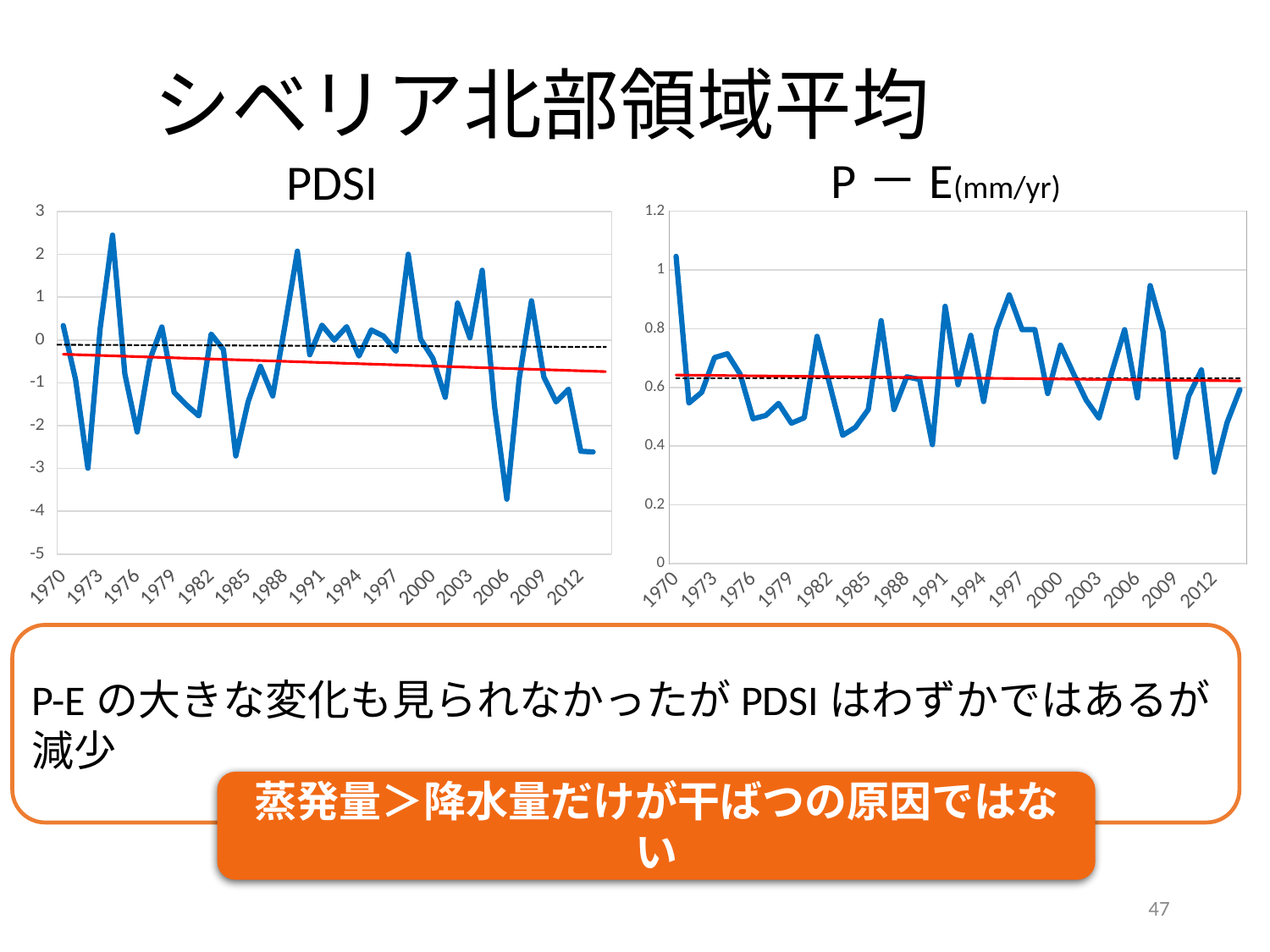
In the PDSI chart, does the red trend line rise or fall from 1970 to 2012? fall In the PDSI chart, which year has the lowest value? 2006 What kind of chart is the P − E chart on the right? line chart In the P − E chart, is the value for 1970 greater or less than 1? greater In the P − E chart, is the value for 1984 greater or less than 0.6? less In the PDSI chart, is the value for 1974 greater or less than 2? greater In the PDSI chart, which is larger, the value for 1974 or the value for 1972? 1974 In the PDSI chart, which year has the highest value? 1974 What kind of chart is the PDSI chart on the left? line chart What unit is shown in the title of the right-hand chart? mm/yr